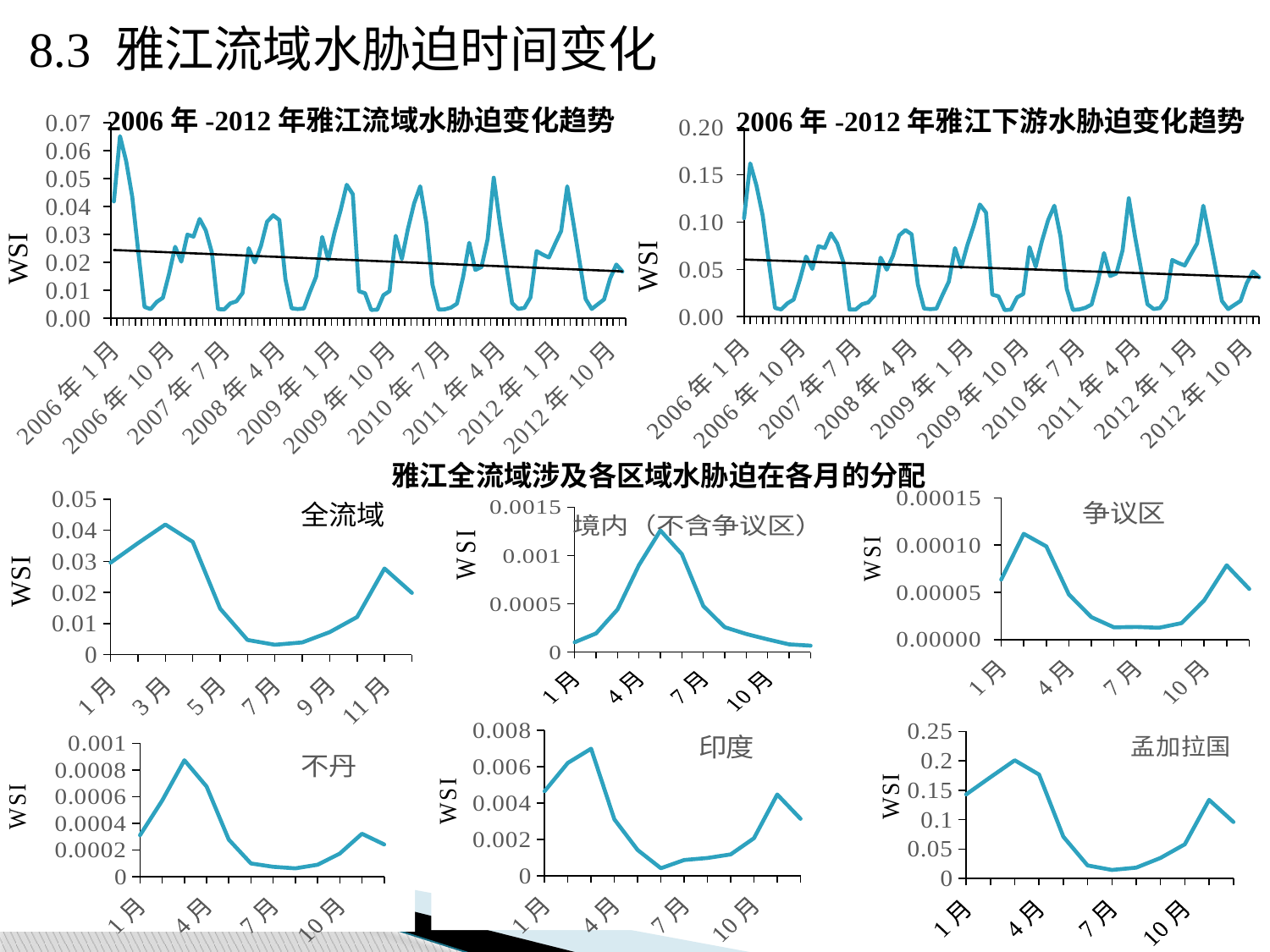
In the '2006年-2012年雅江下游水胁迫变化趋势' chart, does the straight trend line rise or fall from 2006 to 2012? fall In the '全流域' chart, is the WSI value for 3月 greater or less than 0.04? greater In the '孟加拉国' chart, is the WSI value for 7月 greater or less than 0.05? less In the '2006年-2012年雅江流域水胁迫变化趋势' chart, is the highest WSI value (in early 2006) greater or less than 0.06? greater In the '全流域' chart, which month has the highest WSI? 3月 How many monthly distribution charts are shown under the heading '雅江全流域涉及各区域水胁迫在各月的分配'? 6 In the '不丹' chart, which month has the highest WSI? 3月 What kind of chart is the '2006年-2012年雅江流域水胁迫变化趋势' chart? line chart In the '印度' chart, which is larger, the WSI for 4月 or for 11月? 11月